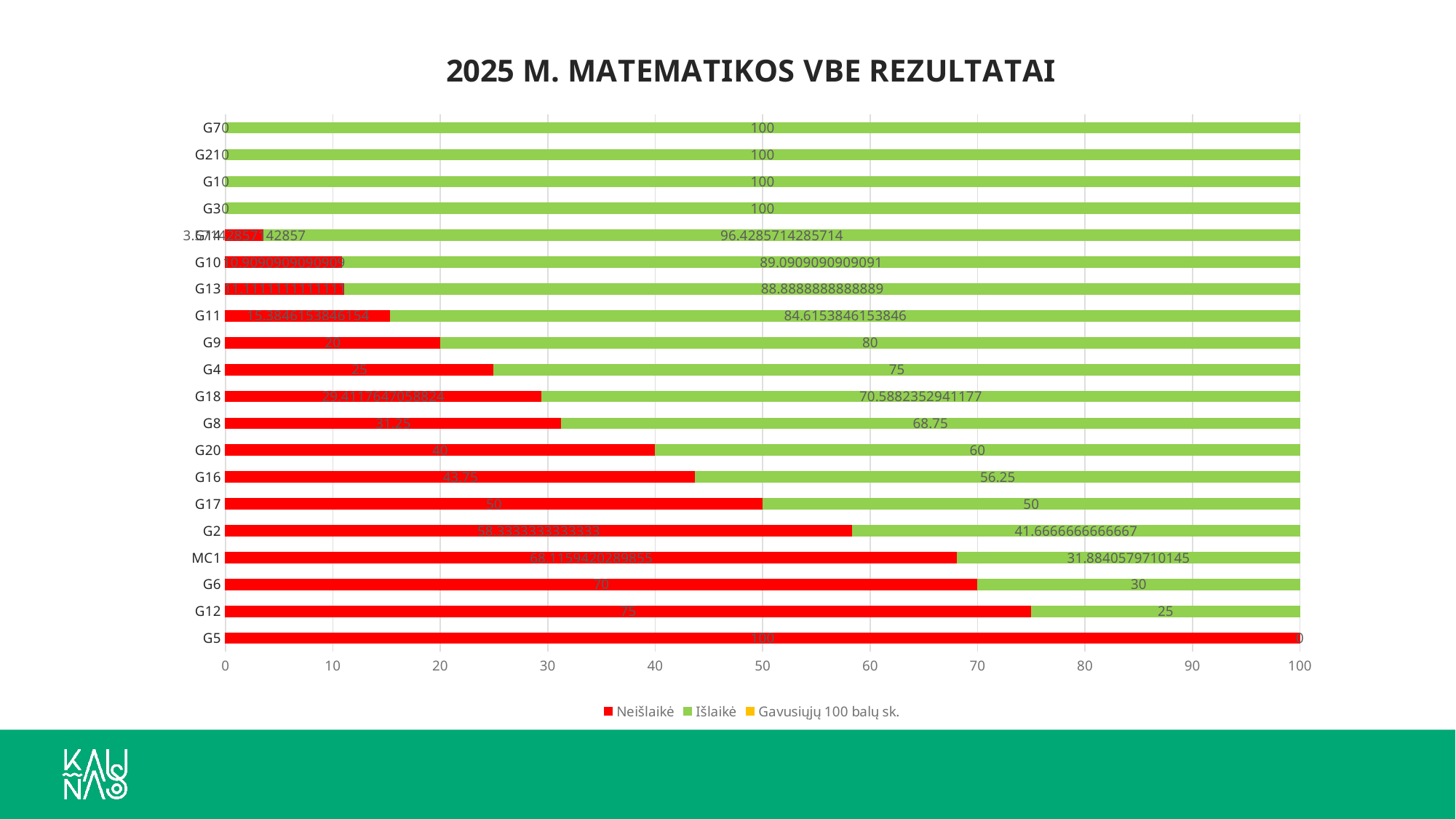
What kind of chart is shown on the slide? bar chart What is the Neišlaikė value for G12? 75 Is the Neišlaikė value for G11 greater or less than 20? less Which category has the highest Neišlaikė value? G5 What is the Išlaikė value for G8? 68.75 What is the Neišlaikė value for G16? 43.75 What is the Išlaikė value for G9? 80 How many categories are plotted on the y axis? 20 Which has the larger Neišlaikė value, G6 or G20? G6 How many series does the legend list? 3 What is the title of the chart? 2025 M. MATEMATIKOS VBE REZULTATAI What is the difference between the Išlaikė values for G4 and G16? 18.75